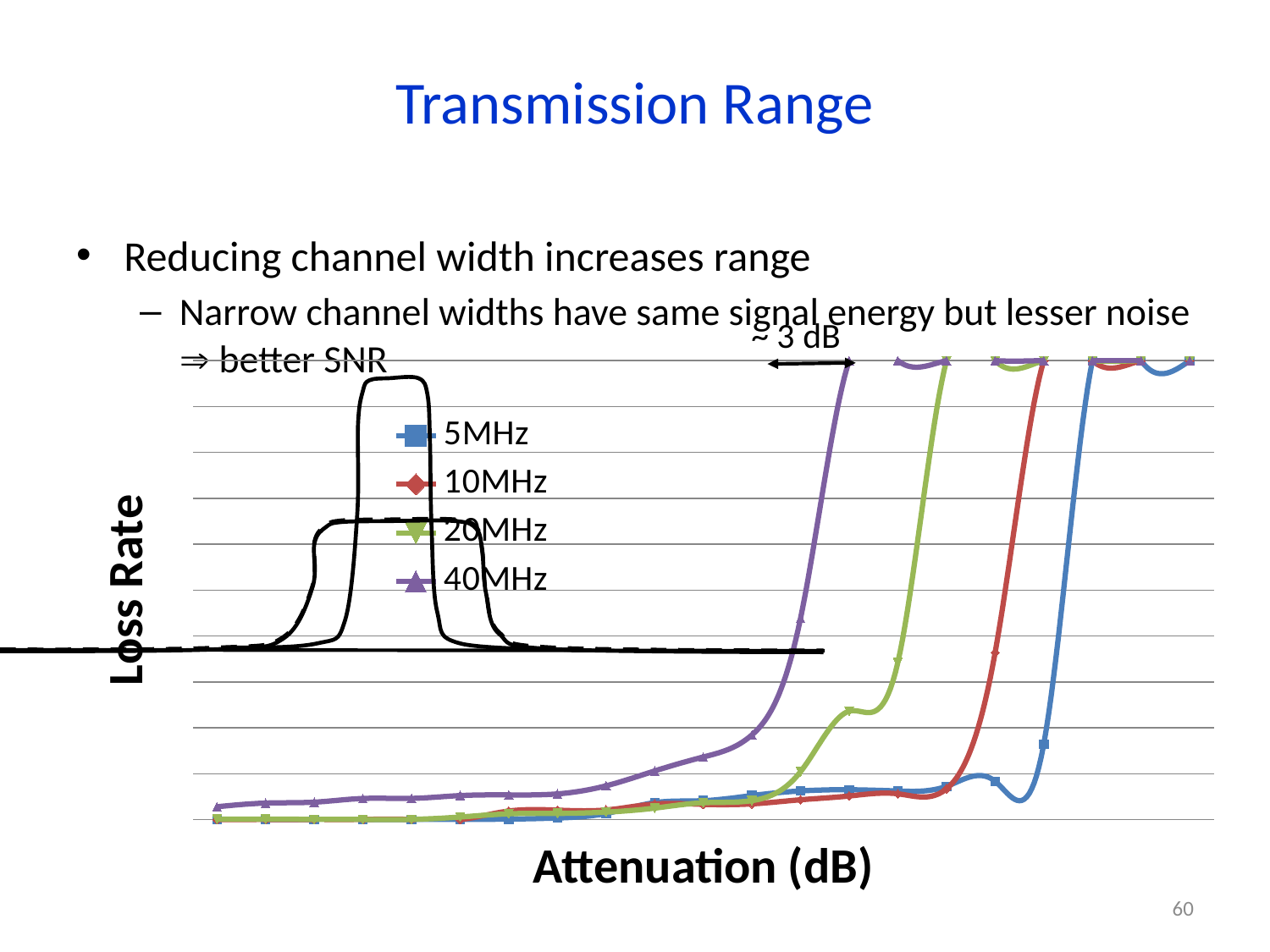
Which series has the higher loss rate at low attenuation, 40MHz or 5MHz? 40MHz Which series keeps a low loss rate up to the highest attenuation? 5MHz What is the title of the horizontal axis of the chart? Attenuation (dB) Which series has the lowest loss rate at the left end of the x axis, 40MHz or 20MHz? 20MHz Which series rises to a high loss rate first, 10MHz or 5MHz? 10MHz What gap is annotated with the double-headed arrow at the top of the chart? ~ 3 dB As attenuation increases along the x axis, does the loss rate for each series rise or fall? rise How many series does the legend list? 4 What kind of chart is shown on the slide? line chart Which series reaches a high loss rate at the lowest attenuation? 40MHz